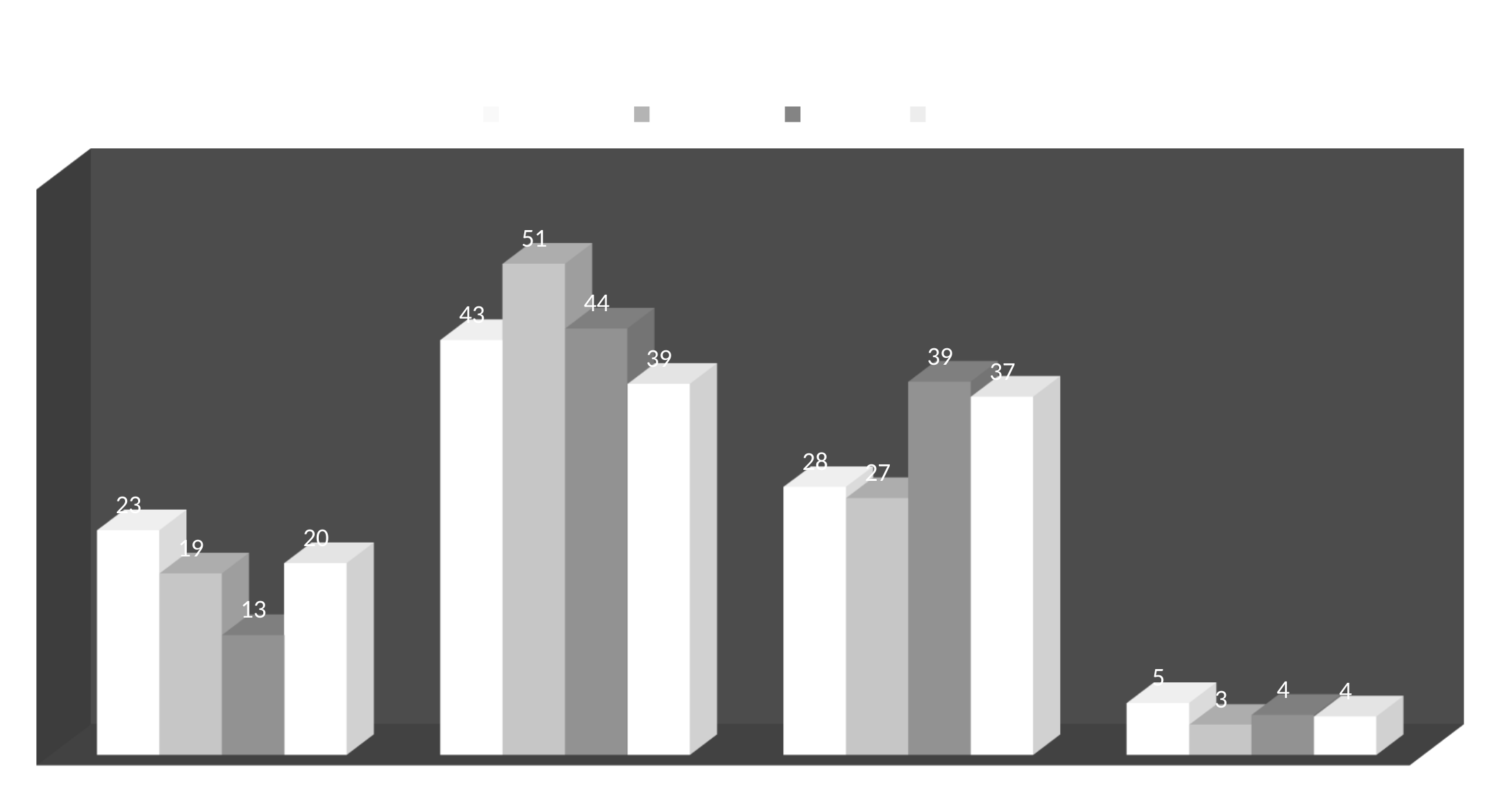
What is the lowest value labelled on the chart? 3 What is the value of the second bar in the second group from the left? 51 In the third group from the left, which is larger: the first bar or the third bar? the third bar (39) How many series does the legend list? 4 Which group of bars has the smallest values overall? the fourth (rightmost) group What kind of chart is shown on the slide? bar chart What is the highest value labelled on the chart? 51 What is the value of the third bar in the first group from the left? 13 What is the value of the fourth bar in the third group from the left? 37 What is the difference between the second bar (51) and the fourth bar (39) in the second group from the left? 12 How many groups of bars are plotted along the x axis? 4 What is the value of the first (leftmost) bar in the first group from the left? 23